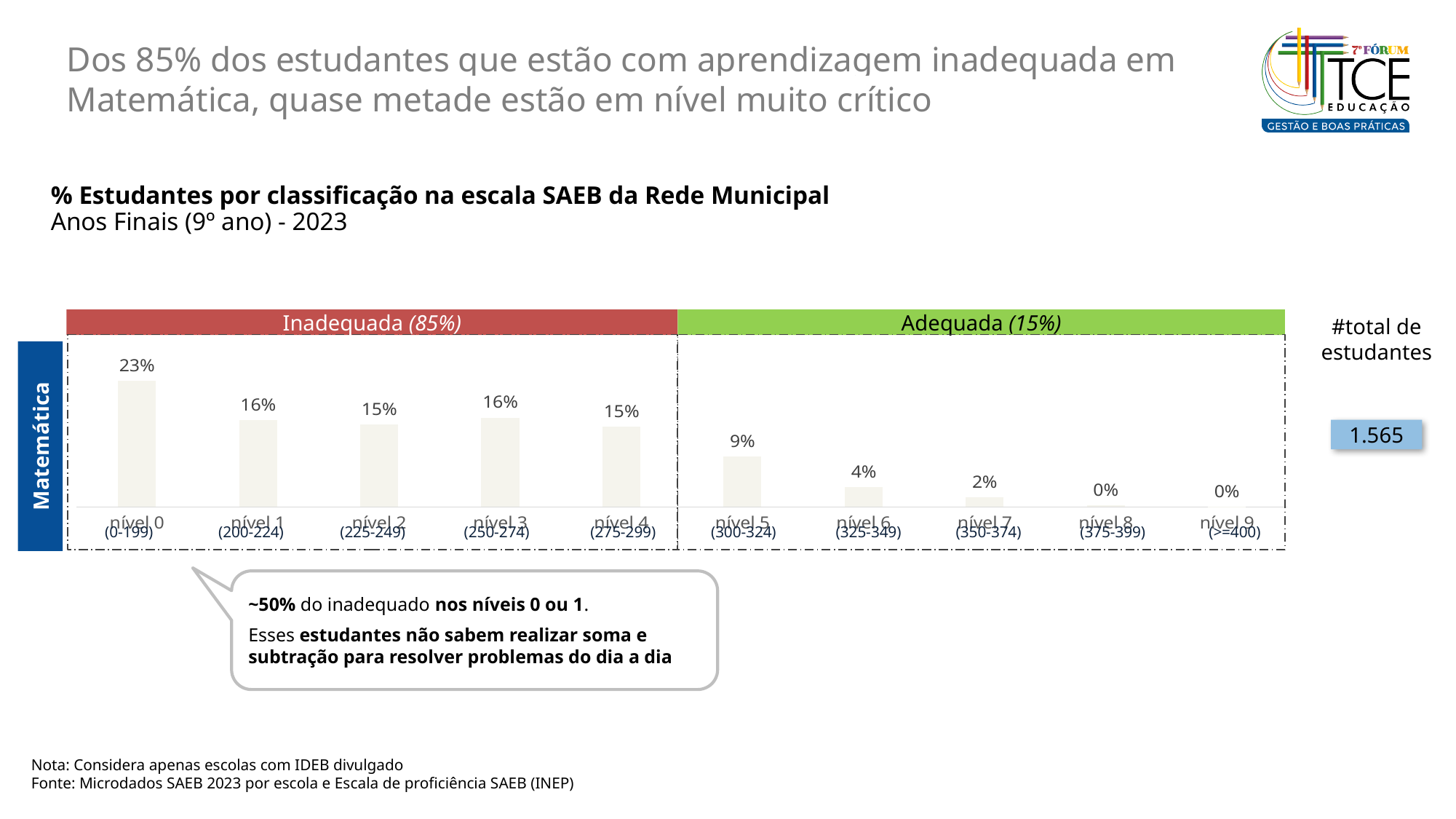
What percentage of students are at nível 0 (0-199)? 23% How many levels (categories) are shown on the x axis of the chart? 10 What is the total number of students (#total de estudantes) shown next to the chart? 1.565 Which is larger, the value for nível 4 or the value for nível 5? nível 4 What is the value shown for nível 5 (300-324)? 9% What is the difference between the percentages for nível 5 and nível 7? 7% What percentage of students are at nível 6 (325-349)? 4% Do the values generally rise or fall from nível 4 to nível 9? fall Which level has the highest percentage of students? nível 0 What percentage of students is labelled as 'Inadequada' in the band above the chart? 85% What kind of chart is shown on the slide? bar chart What is the difference between the percentages for nível 0 and nível 1? 7%